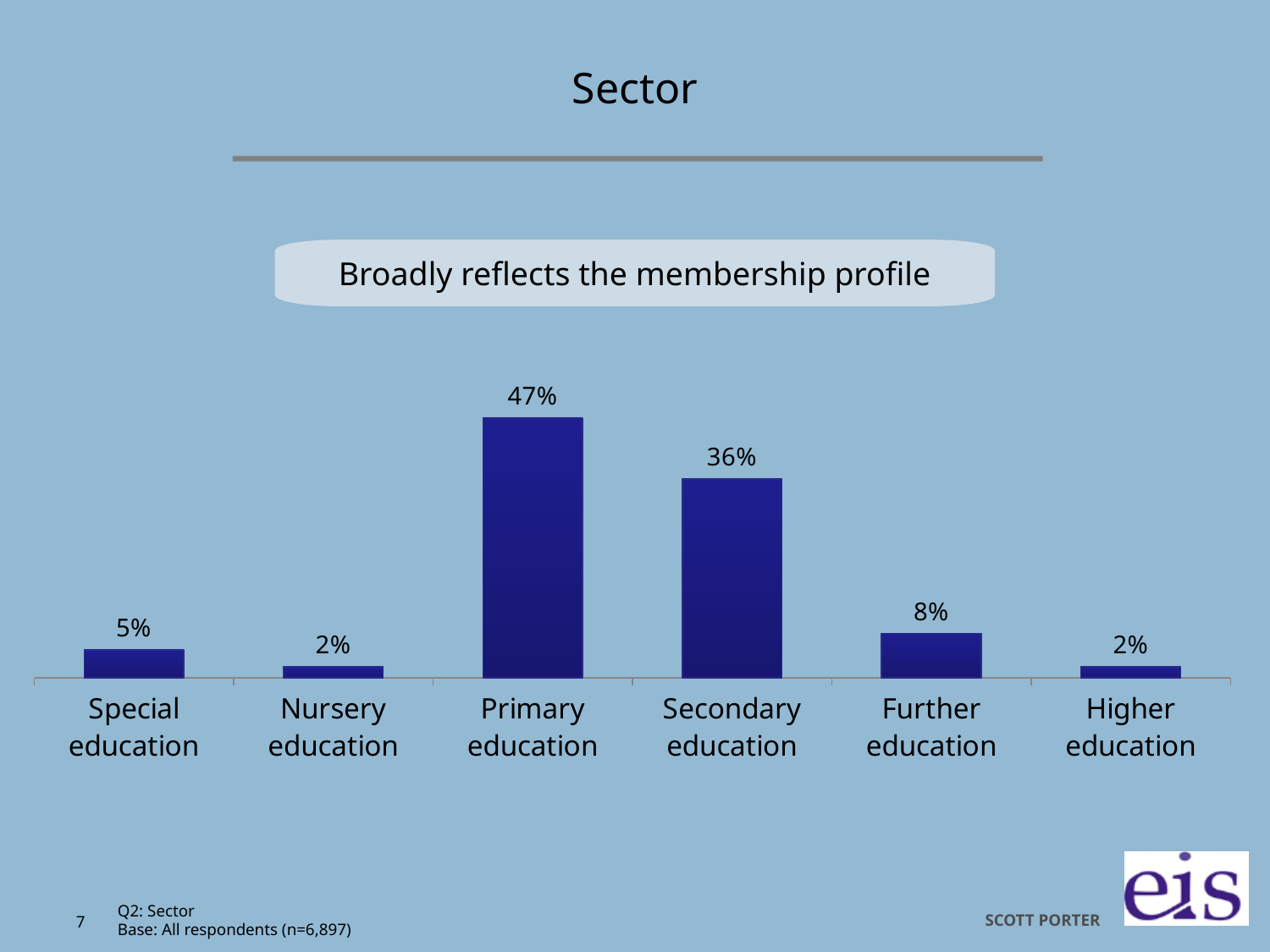
What is the value for Secondary education? 36% What is the title of the slide containing the chart? Sector What is the value for Primary education? 47% Which is larger, the value for Secondary education or the value for Further education? Secondary education Which sector has the highest value? Primary education What kind of chart is shown on the slide? Bar chart How many sectors are shown on the chart? 6 What is the value for Special education? 5% What is the difference between the values for Further education and Special education? 3% What is the value for Further education? 8% Which two sectors share the lowest value of 2%? Nursery education and Higher education What is the difference between the values for Primary education and Secondary education? 11%